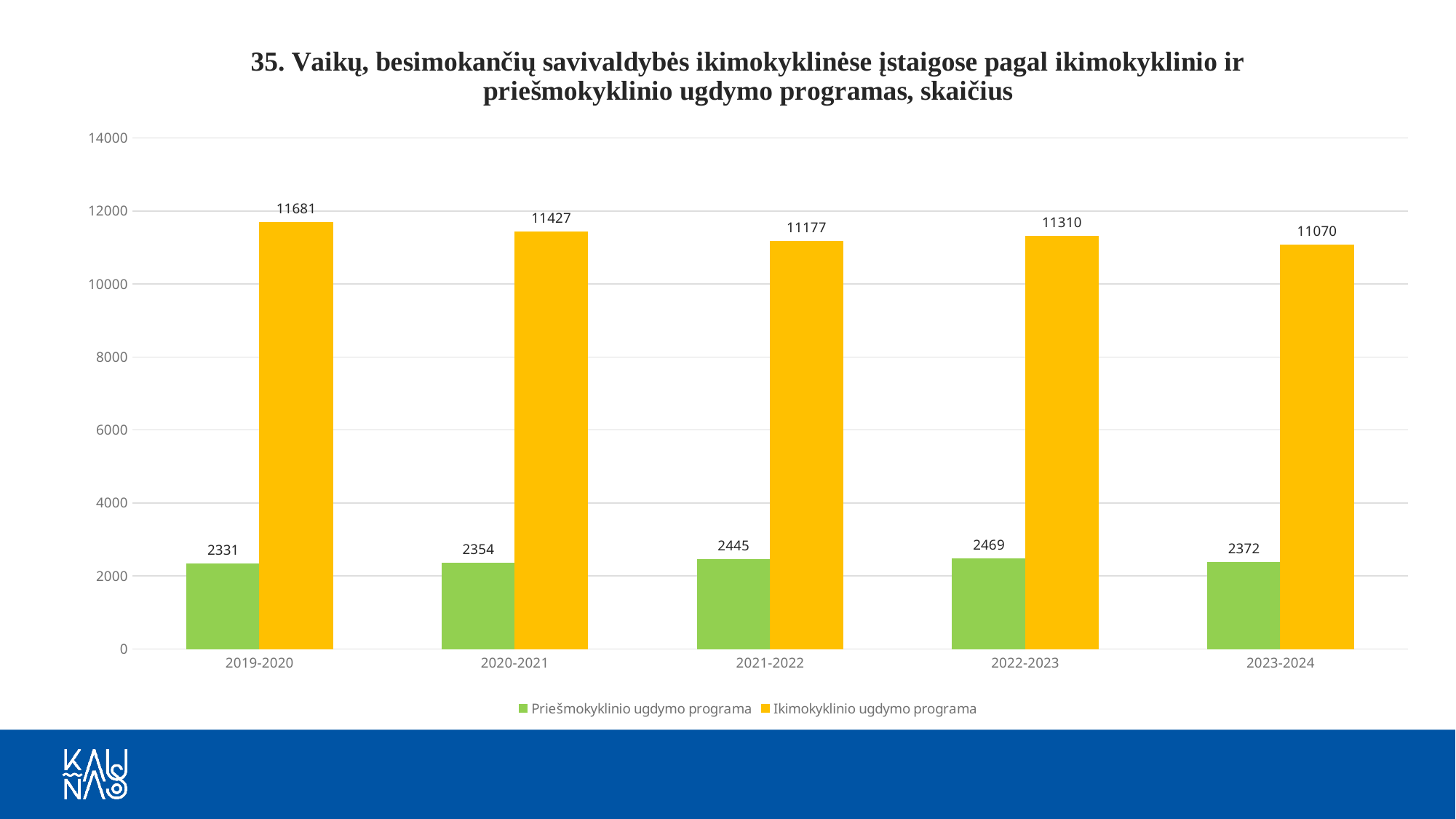
How many series does the legend list? 2 What is the value for Ikimokyklinio ugdymo programa in 2019-2020? 11681 In which period is the value for Ikimokyklinio ugdymo programa lowest? 2023-2024 Is the value for Ikimokyklinio ugdymo programa in 2021-2022 greater or less than 10000? greater Which is larger: the Priešmokyklinio ugdymo programa value in 2021-2022 or in 2023-2024? 2021-2022 Do the values for Ikimokyklinio ugdymo programa rise or fall from 2019-2020 to 2023-2024? fall What is the value for Priešmokyklinio ugdymo programa in 2022-2023? 2469 What is the value for Ikimokyklinio ugdymo programa in 2023-2024? 11070 What is the difference between the Ikimokyklinio ugdymo programa values for 2019-2020 and 2023-2024? 611 How many periods are shown on the x axis? 5 What kind of chart is shown on the slide? bar chart In which period is the value for Priešmokyklinio ugdymo programa highest? 2022-2023